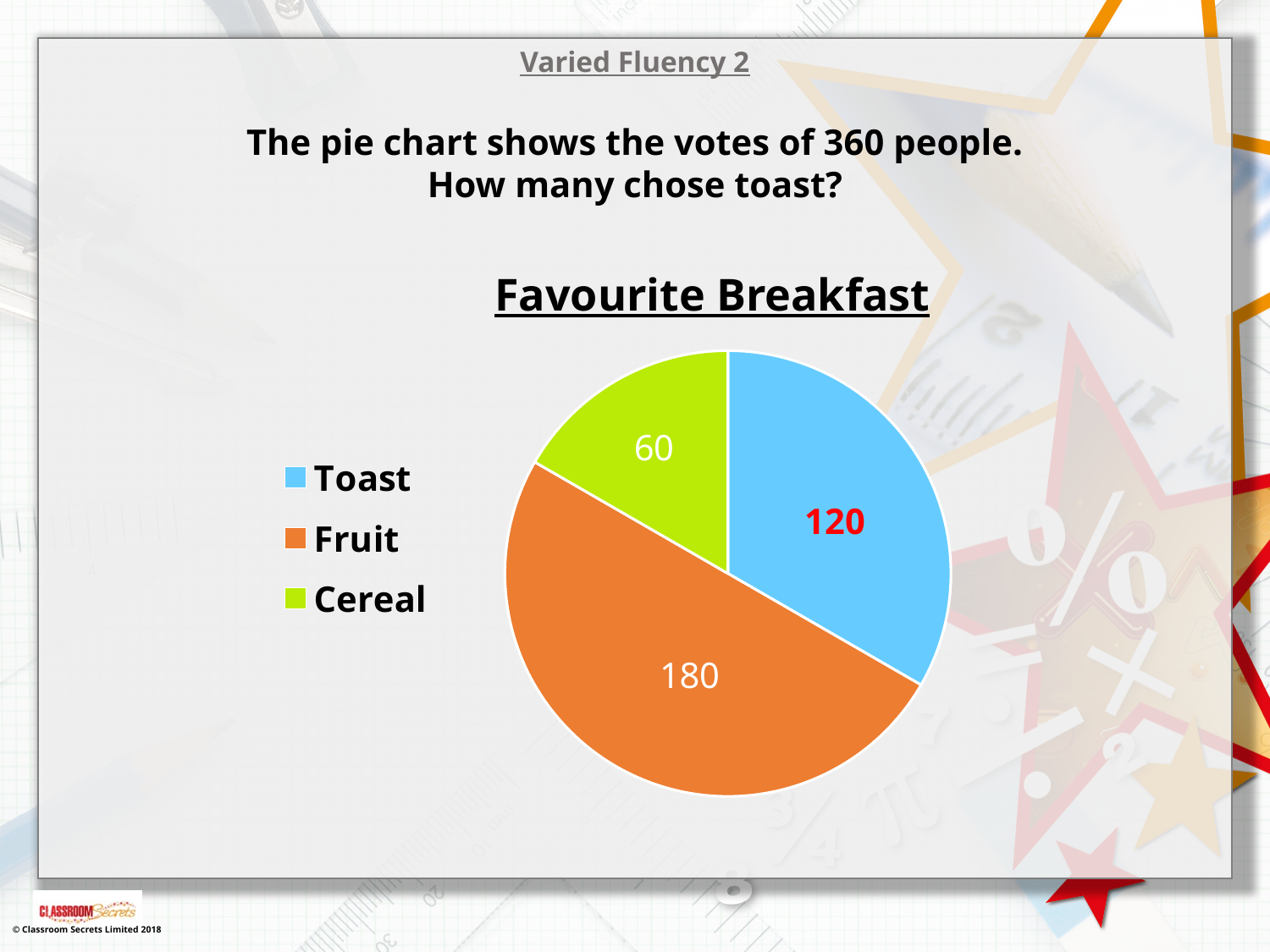
Which is larger in the Favourite Breakfast pie chart, Toast or Cereal? Toast What is the value for Fruit in the Favourite Breakfast pie chart? 180 How many categories are shown in the Favourite Breakfast pie chart? 3 What is the difference between the values for Fruit and Toast in the Favourite Breakfast pie chart? 60 What is the value for Toast in the Favourite Breakfast pie chart? 120 What is the total of all the slices in the Favourite Breakfast pie chart? 360 What is the title of the pie chart on the slide? Favourite Breakfast What share of the Favourite Breakfast pie chart does Fruit represent? 50% What type of chart is shown on the slide? Pie chart What is the value for Cereal in the Favourite Breakfast pie chart? 60 Which category has the largest slice in the Favourite Breakfast pie chart? Fruit Which category has the smallest slice in the Favourite Breakfast pie chart? Cereal